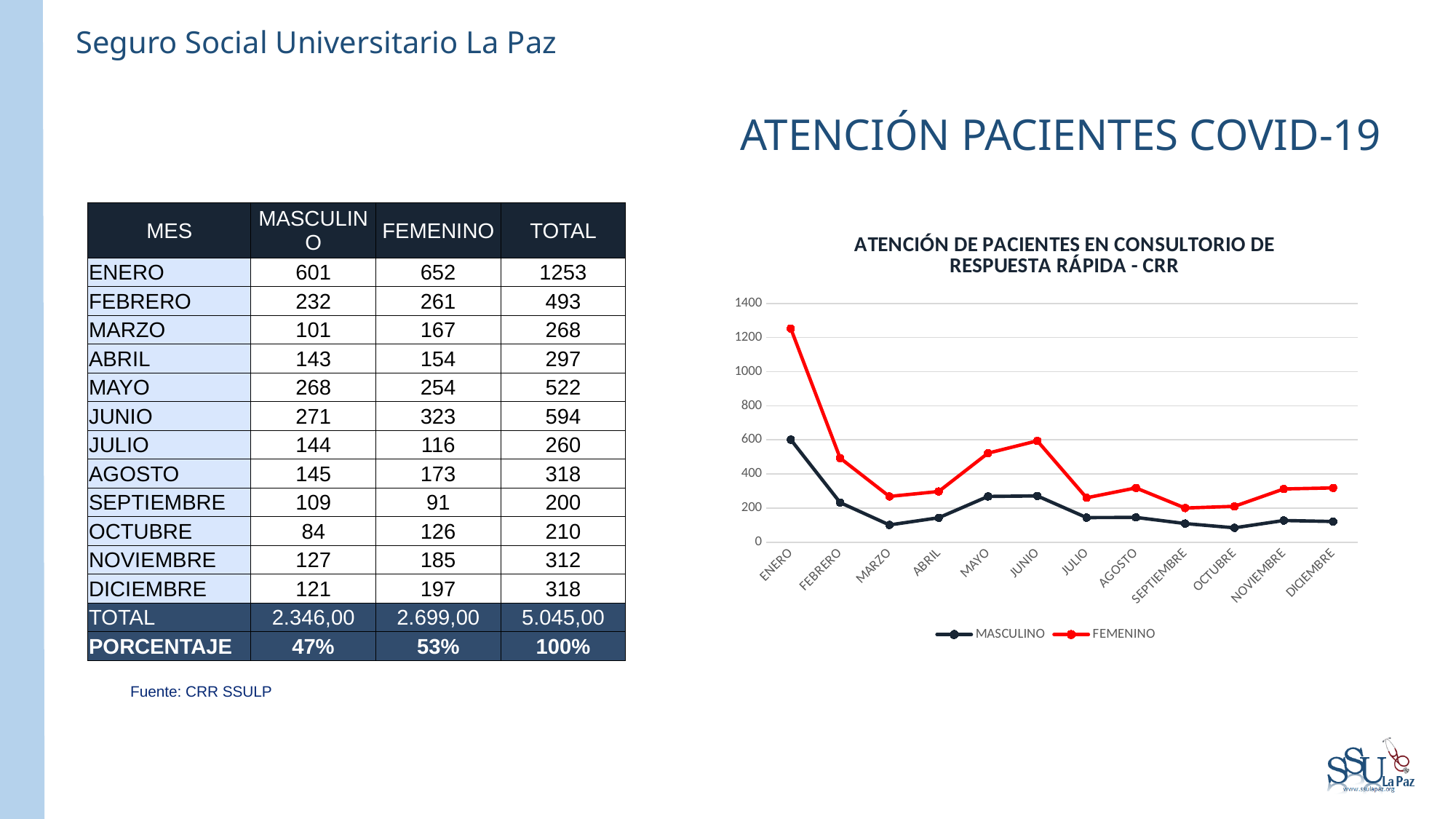
In which month does the FEMENINO line reach its highest value? ENERO Is the MASCULINO value for ENERO greater or less than 800? less How many months are plotted along the x axis of the chart? 12 How many series does the chart's legend list? 2 Do the values of both lines rise or fall from ENERO to MARZO? fall What colour is the FEMENINO line in the chart? Red What kind of chart is shown on the slide? Line chart In which month does the MASCULINO line reach its highest value? ENERO In JUNIO, which series has the larger value, MASCULINO or FEMENINO? FEMENINO Is the MASCULINO value for MARZO greater or less than 200? less